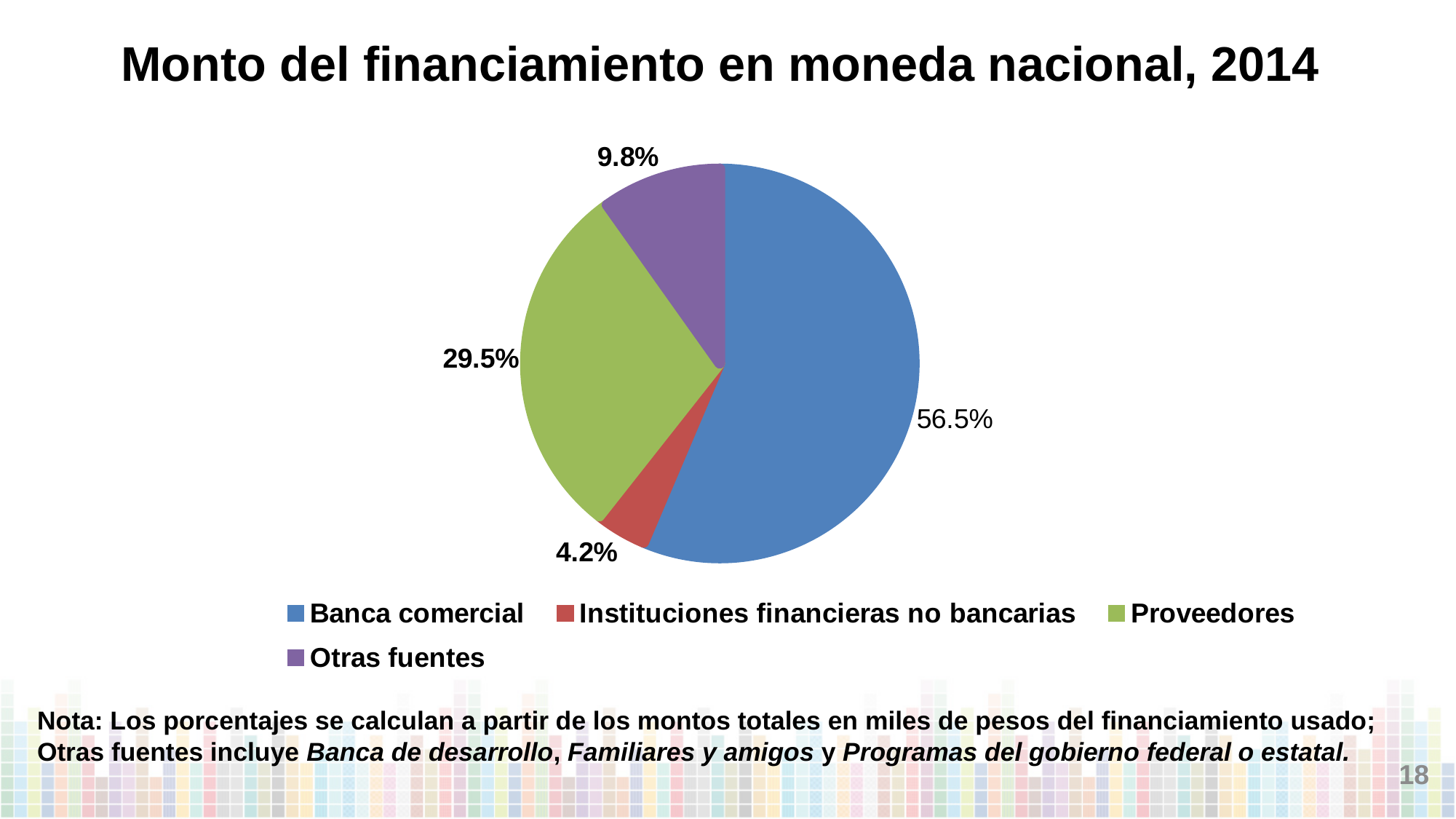
What is the share for Banca comercial? 56.5% Which category has the largest share of the pie? Banca comercial How many categories does the pie chart have? 4 What is the difference in percentage points between Banca comercial and Proveedores? 27.0 percentage points What is the share for Proveedores? 29.5% What is the title of the chart? Monto del financiamiento en moneda nacional, 2014 What is the share for Instituciones financieras no bancarias? 4.2% What is the share for Otras fuentes? 9.8% What colour is the slice for Proveedores? Green Which category has the smallest share of the pie? Instituciones financieras no bancarias Which is larger, the share for Otras fuentes or the share for Instituciones financieras no bancarias? Otras fuentes What type of chart is shown on the slide? Pie chart